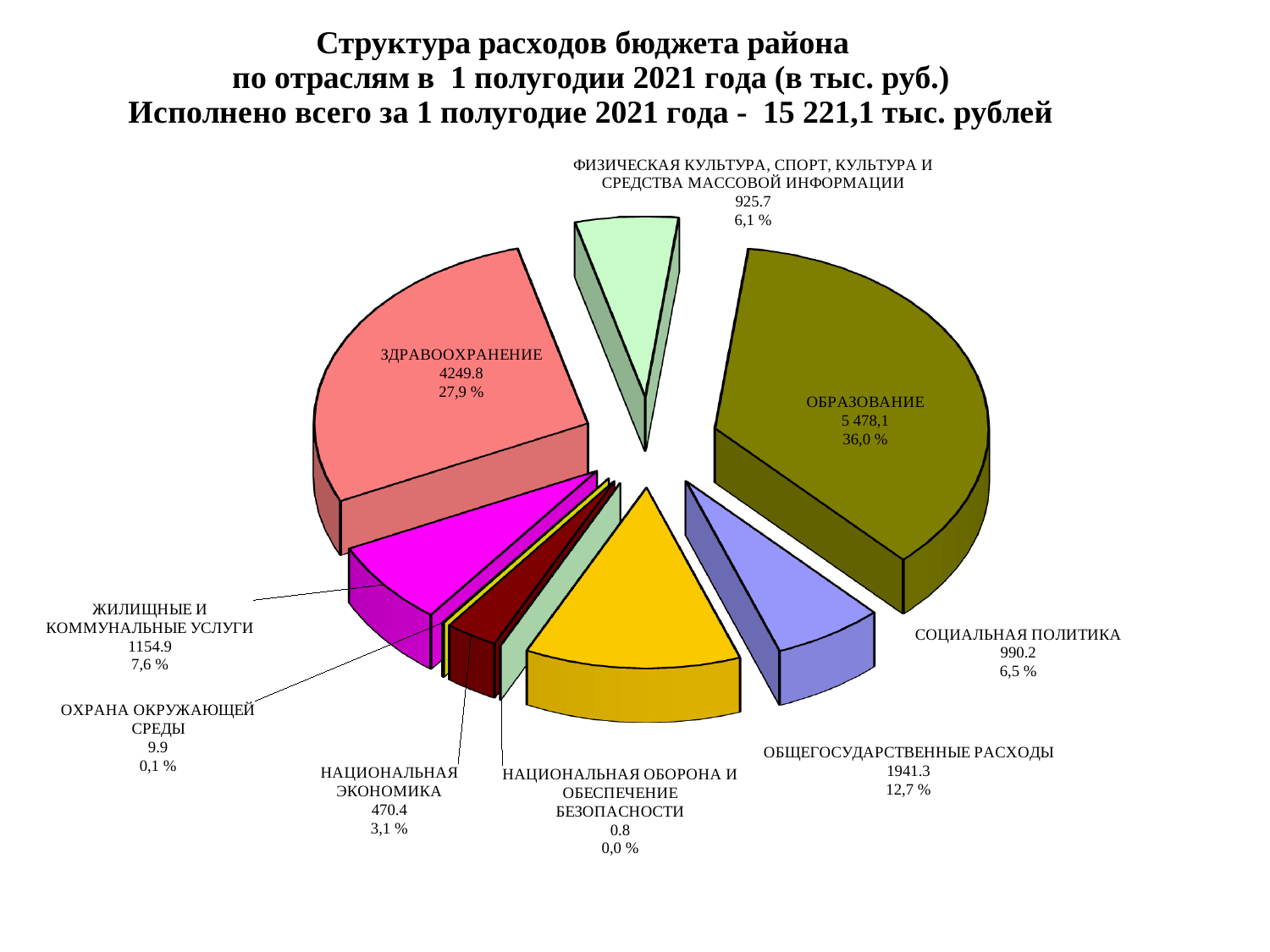
According to the slide title, what is the total executed amount for the first half of 2021? 15 221,1 тыс. рублей Which category has the smallest slice of the pie? НАЦИОНАЛЬНАЯ ОБОРОНА И ОБЕСПЕЧЕНИЕ БЕЗОПАСНОСТИ Which is larger: the value for ФИЗИЧЕСКАЯ КУЛЬТУРА, СПОРТ, КУЛЬТУРА И СРЕДСТВА МАССОВОЙ ИНФОРМАЦИИ or the value for НАЦИОНАЛЬНАЯ ЭКОНОМИКА? ФИЗИЧЕСКАЯ КУЛЬТУРА, СПОРТ, КУЛЬТУРА И СРЕДСТВА МАССОВОЙ ИНФОРМАЦИИ What share of the pie does ЗДРАВООХРАНЕНИЕ represent? 27,9 % How many categories (slices) does the pie chart show? 9 What is the value for ОБЩЕГОСУДАРСТВЕННЫЕ РАСХОДЫ? 1941.3 What is the value for СОЦИАЛЬНАЯ ПОЛИТИКА? 990.2 What share of the pie does ОХРАНА ОКРУЖАЮЩЕЙ СРЕДЫ represent? 0,1 % What kind of chart is shown on the slide? pie chart Which category has the largest slice of the pie? ОБРАЗОВАНИЕ What is the difference between the values for ЖИЛИЩНЫЕ И КОММУНАЛЬНЫЕ УСЛУГИ and СОЦИАЛЬНАЯ ПОЛИТИКА? 164.7 What is the value for ОБРАЗОВАНИЕ? 5 478,1